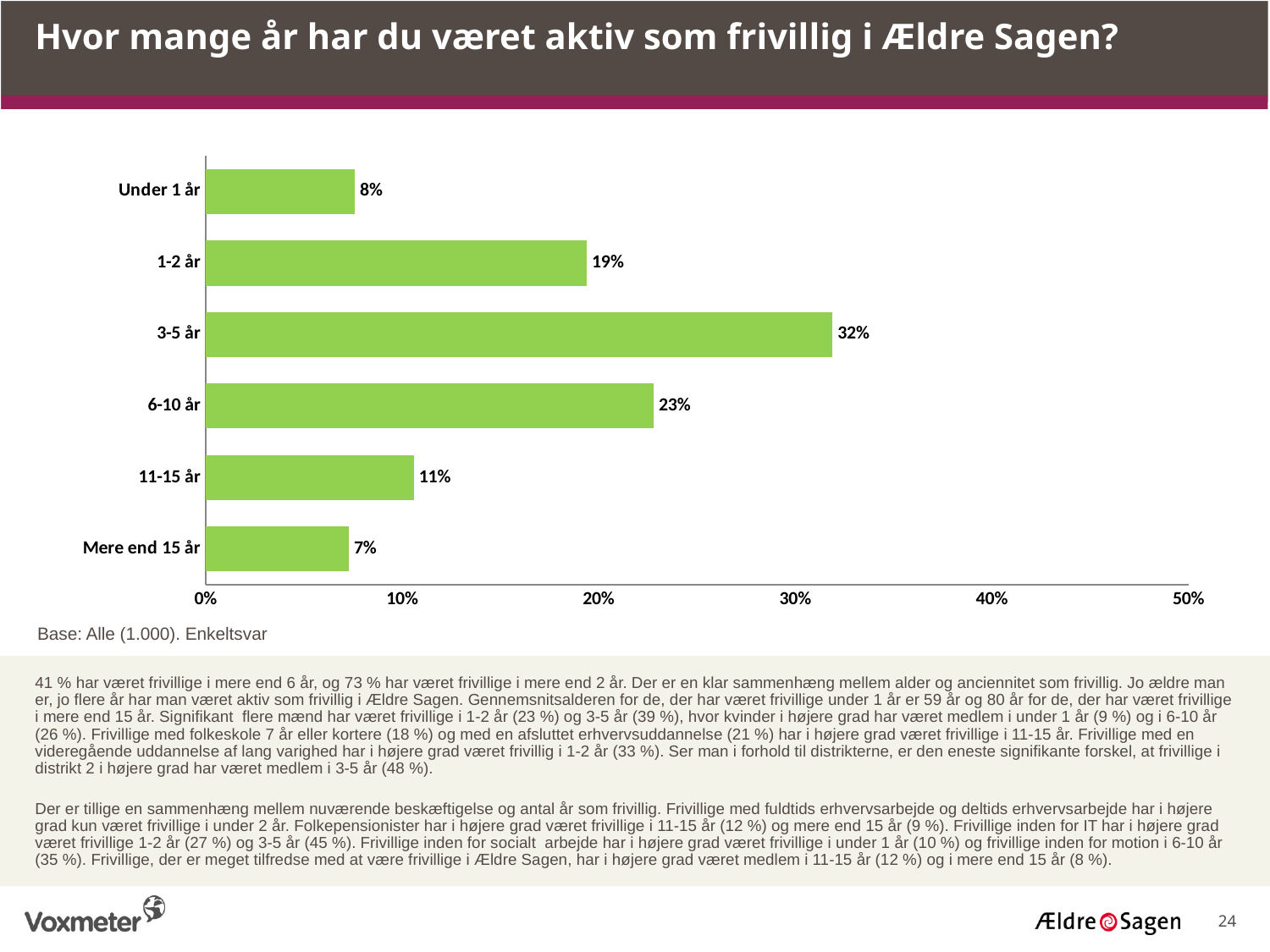
Which category has the lowest value in the chart? Mere end 15 år What is the difference between the values for '3-5 år' and '6-10 år'? 9% What is the title of the chart on the slide? Hvor mange år har du været aktiv som frivillig i Ældre Sagen? Which category has the highest value in the chart? 3-5 år Which is larger, the value for '1-2 år' or the value for '6-10 år'? 6-10 år What kind of chart is shown on the slide? Bar chart What percentage is shown for 'Mere end 15 år'? 7% Is the value for '6-10 år' greater or less than 20%? greater How many categories are shown in the chart? 6 What percentage of respondents have been active as volunteers for 3-5 år? 32% What is the value shown for the category 'Under 1 år'? 8% What is the difference between the values for '1-2 år' and '11-15 år'? 8%